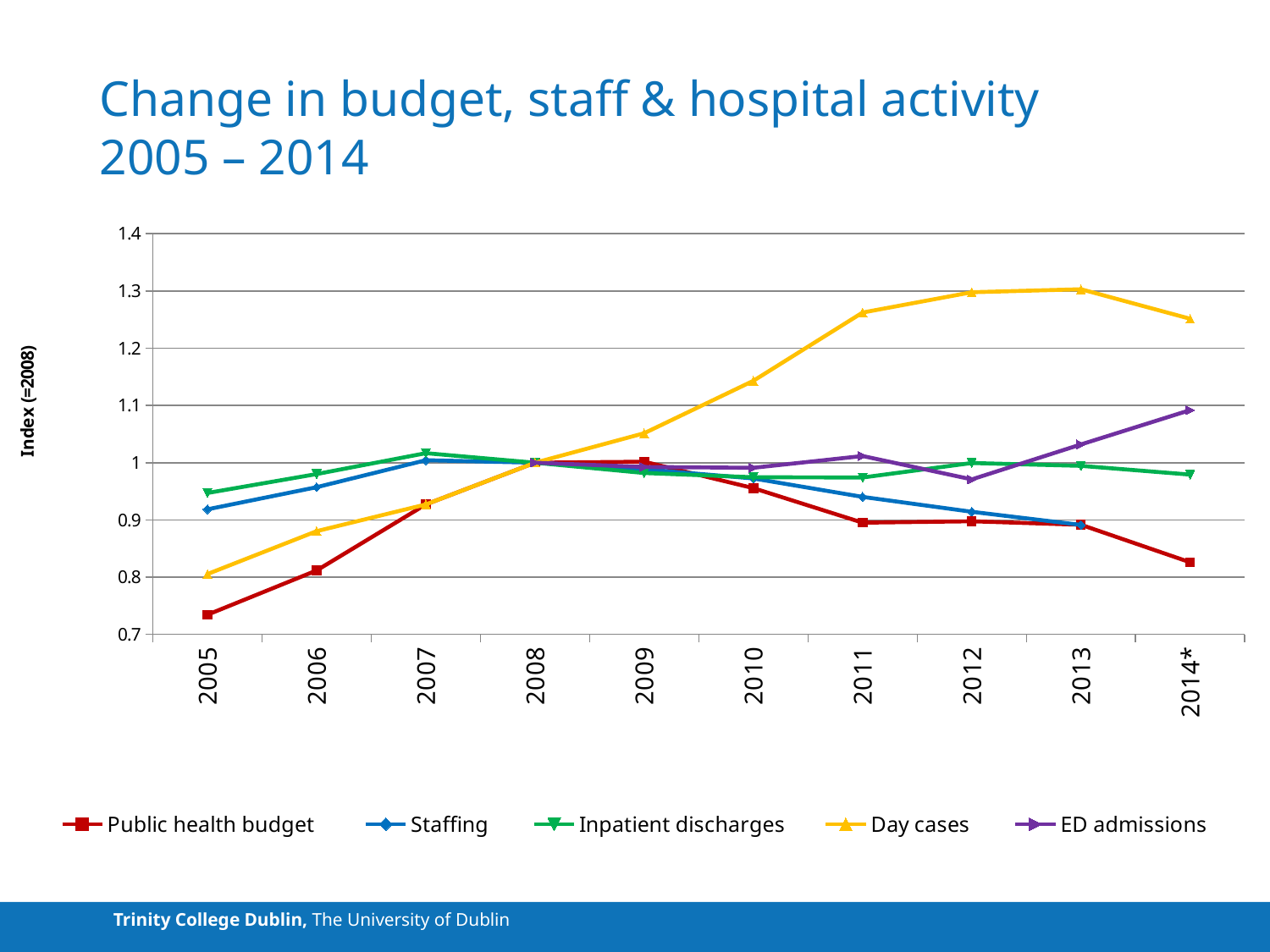
What is the label on the vertical axis? Index (=2008) How many series does the legend list? 5 Which series has the highest value in 2014*? Day cases Which series has the lowest value in 2014*? Public health budget What is the index value for Public health budget in 2008? 1 What kind of chart is shown on the slide? line chart Is the value for ED admissions in 2014* greater or less than 1? greater In 2011, which is larger: Day cases or Staffing? Day cases How many years are plotted along the x axis? 10 Is the value for Public health budget in 2005 greater or less than 0.8? less Is the value for Day cases in 2012 greater or less than 1.2? greater Does the Public health budget line rise or fall between 2009 and 2014*? fall